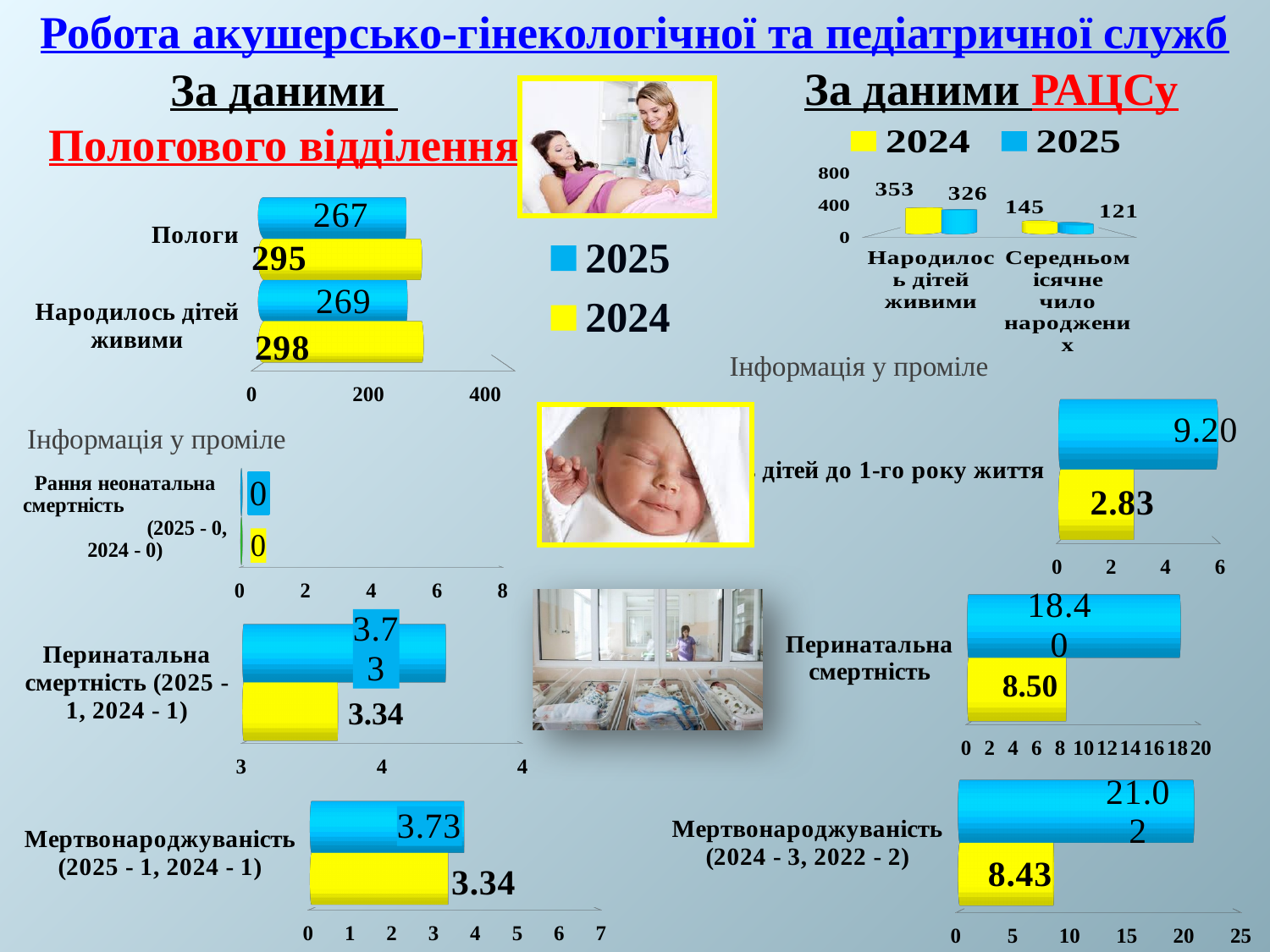
In the 'Мертвонароджуваність (2024 - 3, 2022 - 2)' chart on the right side of the slide, what is the value of the yellow bar? 8.43 In the 'Перинатальна смертність' chart on the right side of the slide, what is the value of the blue bar? 18.40 What kind of chart is the 'За даними Пологового відділення' chart? bar chart In the 'За даними РАЦСу' chart, what is the 2024 value for Народилось дітей живими? 353 In the 'За даними Пологового відділення' chart, what is the 2025 value for Народилось дітей живими? 269 In the 'За даними Пологового відділення' chart, what is the 2024 value for Пологи? 295 In the 'Мертвонароджуваність (2025 - 1, 2024 - 1)' chart on the left side of the slide, what is the value of the blue bar? 3.73 In the 'За даними Пологового відділення' chart, what is the difference between the 2024 and 2025 values for Пологи? 28 In the 'За даними РАЦСу' chart, which year has the larger value for Народилось дітей живими, 2024 or 2025? 2024 In the 'Перинатальна смертність (2025 - 1, 2024 - 1)' chart on the left side of the slide, what is the value of the yellow bar? 3.34 In the 'За даними РАЦСу' chart, how many series does the legend list? 2 In the 'За даними РАЦСу' chart, what is the 2025 value for Середньомісячне число народжених? 121